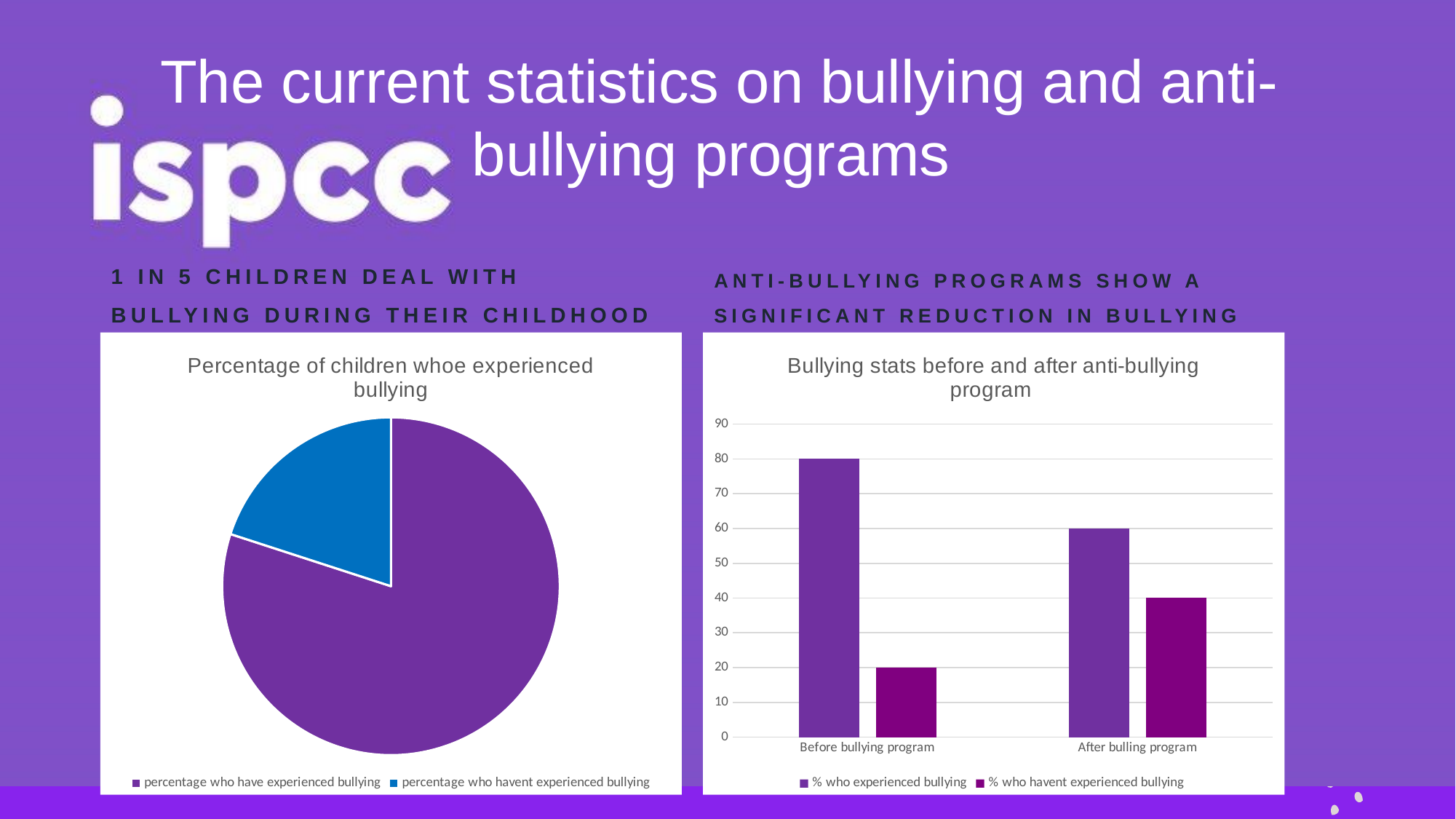
In the chart titled "Bullying stats before and after anti-bullying program", which is larger: "% who experienced bullying" after the program or "% who havent experienced bullying" after the program? % who experienced bullying How many categories are shown on the x axis of the chart titled "Bullying stats before and after anti-bullying program"? 2 In the chart titled "Bullying stats before and after anti-bullying program", what is the value for "% who experienced bullying" before the bullying program? 80 In the chart titled "Bullying stats before and after anti-bullying program", which bar is the lowest? % who havent experienced bullying, Before bullying program What type of chart is the chart titled "Bullying stats before and after anti-bullying program"? bar chart In the chart titled "Bullying stats before and after anti-bullying program", what is the value for "% who havent experienced bullying" after the bulling program? 40 In the chart titled "Bullying stats before and after anti-bullying program", what is the difference between "% who experienced bullying" before and after the program? 20 In the chart titled "Percentage of children whoe experienced bullying", what colour is the slice for "percentage who havent experienced bullying"? blue What type of chart is the chart titled "Percentage of children whoe experienced bullying"? pie chart In the chart titled "Bullying stats before and after anti-bullying program", what is the value for "% who experienced bullying" after the bulling program? 60 In the chart titled "Percentage of children whoe experienced bullying", which slice is larger: "percentage who have experienced bullying" or "percentage who havent experienced bullying"? percentage who have experienced bullying How many series does the legend list in the chart titled "Bullying stats before and after anti-bullying program"? 2